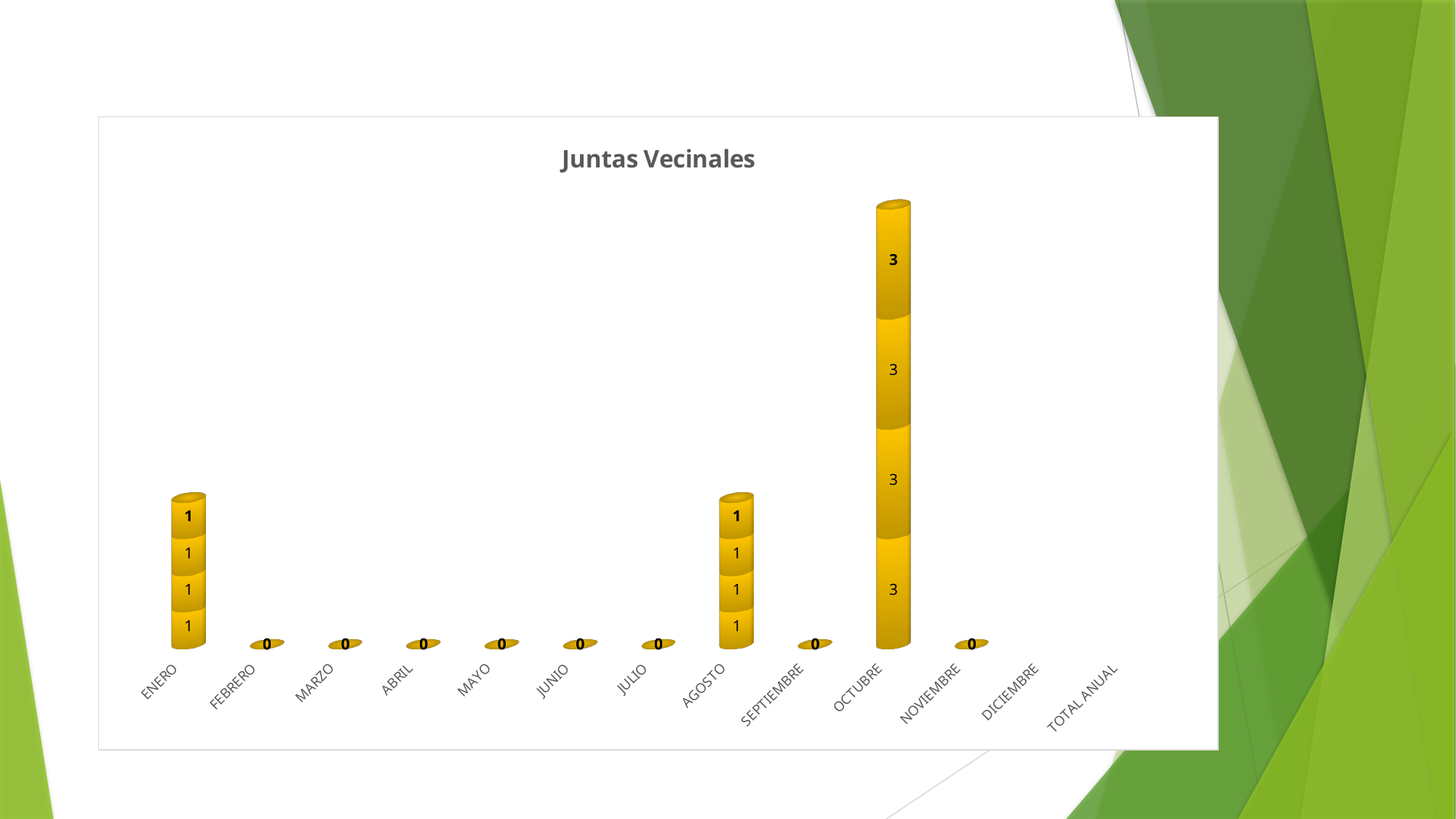
What value is labelled on each segment of the AGOSTO bar? 1 What type of chart is shown on the slide? bar chart How many stacked segments make up the OCTUBRE bar? 4 What value is labelled on each segment of the OCTUBRE bar? 3 What is the title of the chart? Juntas Vecinales What value is labelled for FEBRERO? 0 Which month has the tallest bar in the Juntas Vecinales chart? OCTUBRE What is the difference between a single OCTUBRE segment value and a single ENERO segment value? 2 How many categories are listed along the x axis? 13 What is the total of the stacked ENERO bar? 4 Which bar is taller, OCTUBRE or ENERO? OCTUBRE What is the total of the stacked OCTUBRE bar? 12